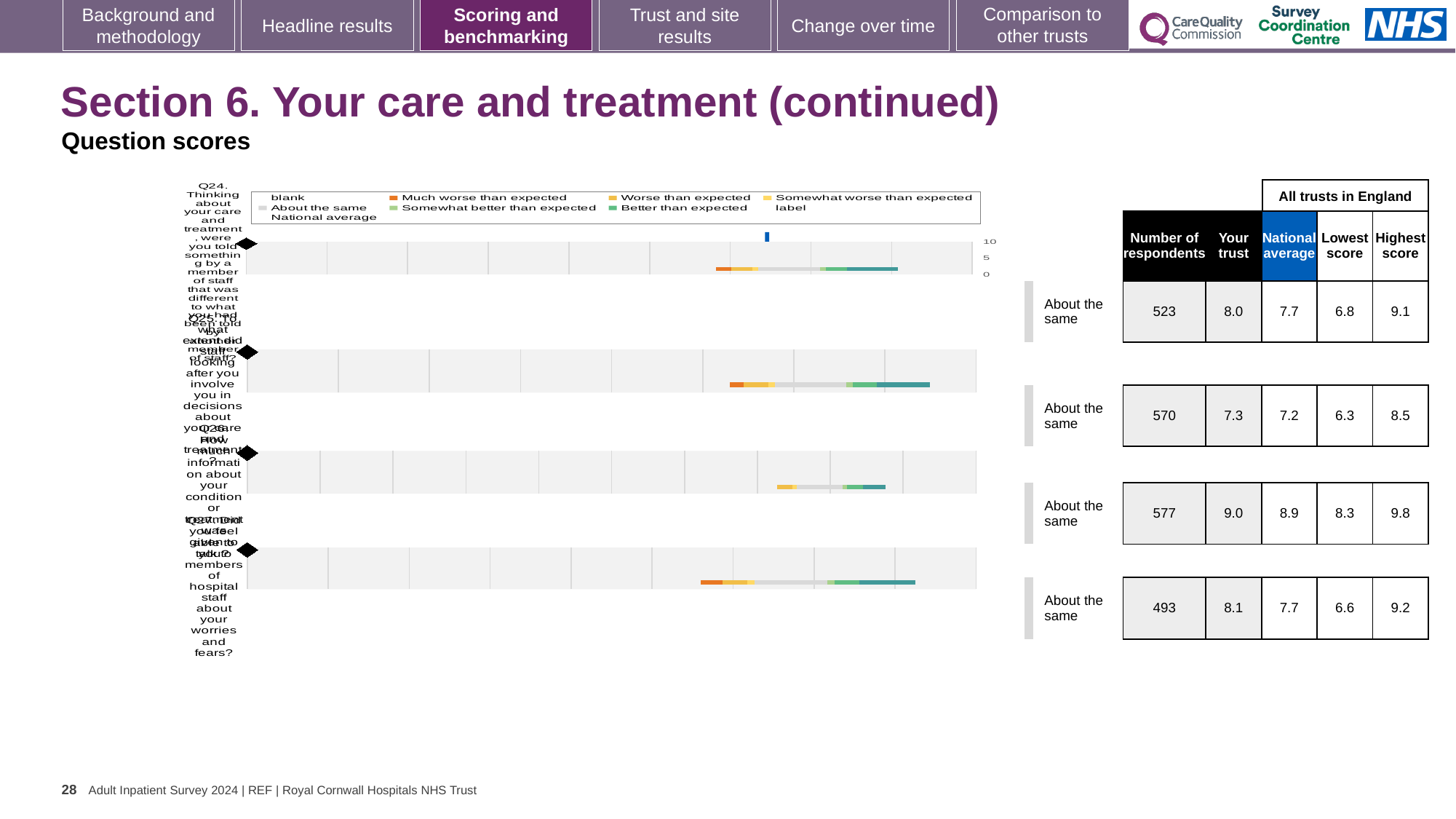
How many question charts are shown on the slide? 4 What benchmark category is shown next to the top chart (Q24)? About the same Across the four charts, which question has the highest 'Your trust' score? Q26 For the bottom chart (Q27), what is the difference between the trust score and the national average? 0.4 For the third chart (Q26), what is the highest score among all trusts in England? 9.8 For the top chart (Q24), what is the score for 'Your trust' shown in the table? 8.0 For the second chart (Q25), how many respondents are shown in the table? 570 For the bottom chart (Q27), what is the lowest score among all trusts in England? 6.6 Across the four charts, which question has the fewest respondents? Q27 What kind of chart is used for each question on the slide? bar chart For the top chart (Q24), what is the national average shown in the table? 7.7 For the second chart (Q25), is the trust score higher or lower than the national average? higher